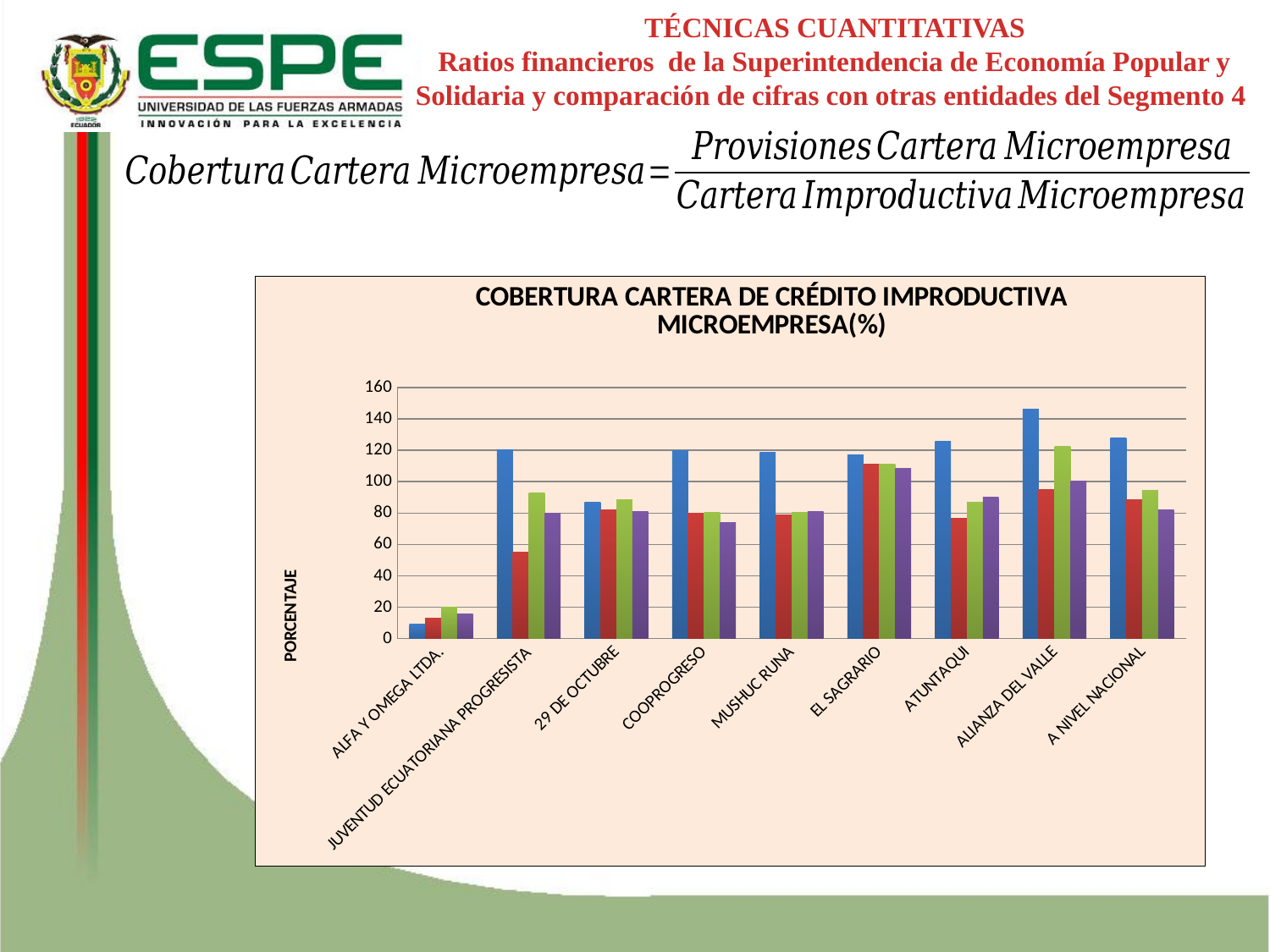
Is the value of the blue bar for ALFA Y OMEGA LTDA. greater or less than 20? less Which is larger: the blue bar for ALIANZA DEL VALLE or the blue bar for 29 DE OCTUBRE? the blue bar for ALIANZA DEL VALLE What is the label of the vertical axis of the chart? PORCENTAJE Is the value of the blue bar for ALIANZA DEL VALLE greater or less than 140? greater How many categories (entities) are shown on the x axis of the chart? 9 For JUVENTUD ECUATORIANA PROGRESISTA, which is larger: the blue bar or the red bar? the blue bar Is the value of the blue bar for A NIVEL NACIONAL greater or less than 120? greater Which category has the lowest bars in the chart? ALFA Y OMEGA LTDA. What is the title of the chart? COBERTURA CARTERA DE CRÉDITO IMPRODUCTIVA MICROEMPRESA(%) Which category has the tallest bar in the chart? ALIANZA DEL VALLE What type of chart is shown on the slide? bar chart